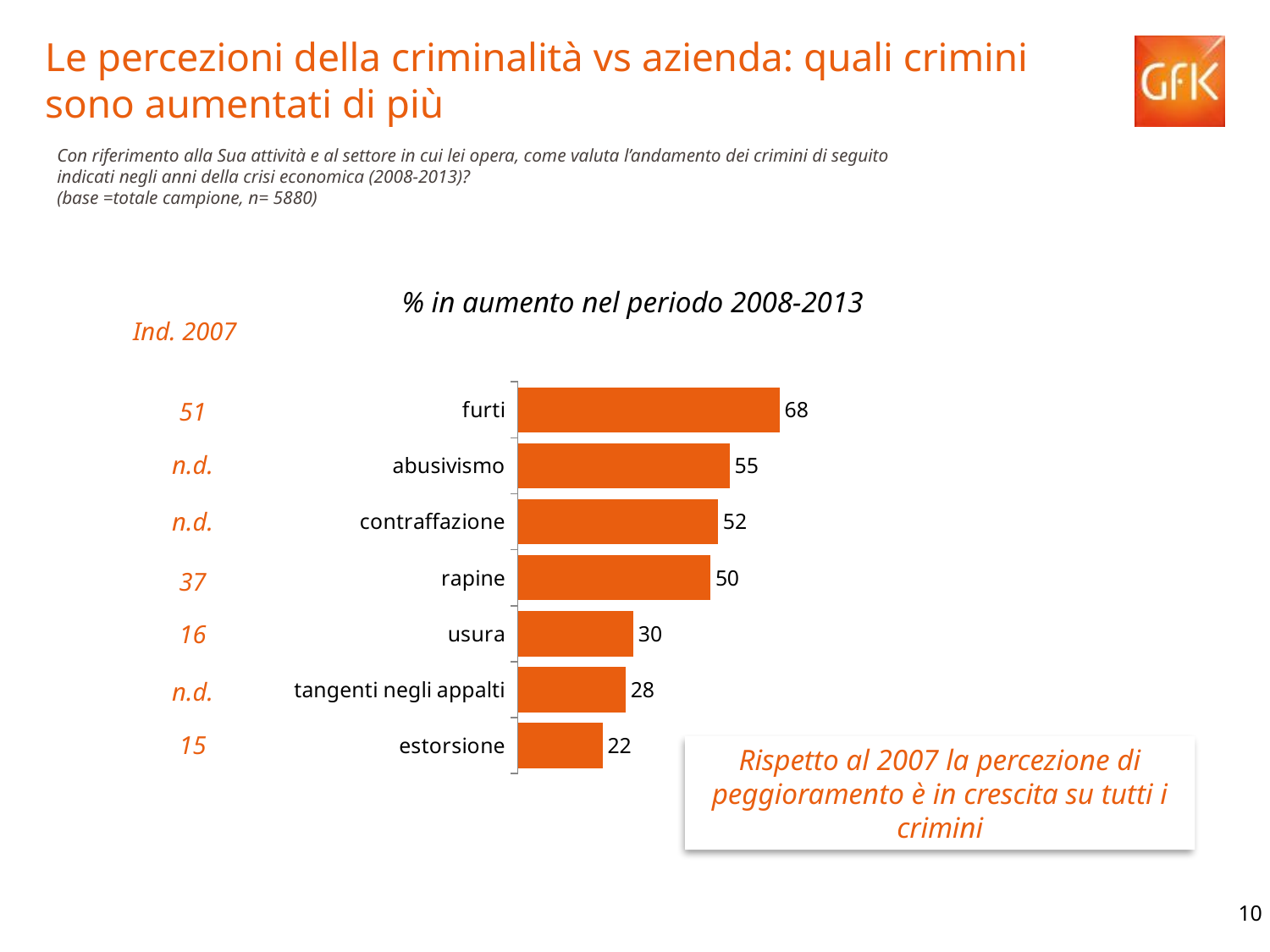
Which category has the lowest value? estorsione What is the value for rapine? 50 Which is larger, the value for usura or the value for rapine? rapine What is the difference between the values for abusivismo and contraffazione? 3 What colour are the bars in the chart? orange What is the value for furti? 68 Which category has the highest value? furti What kind of chart is shown on the slide? bar chart What is the value for tangenti negli appalti? 28 What is the title of the chart? % in aumento nel periodo 2008-2013 How many categories are shown in the chart? 7 What is the difference between the values for furti and estorsione? 46